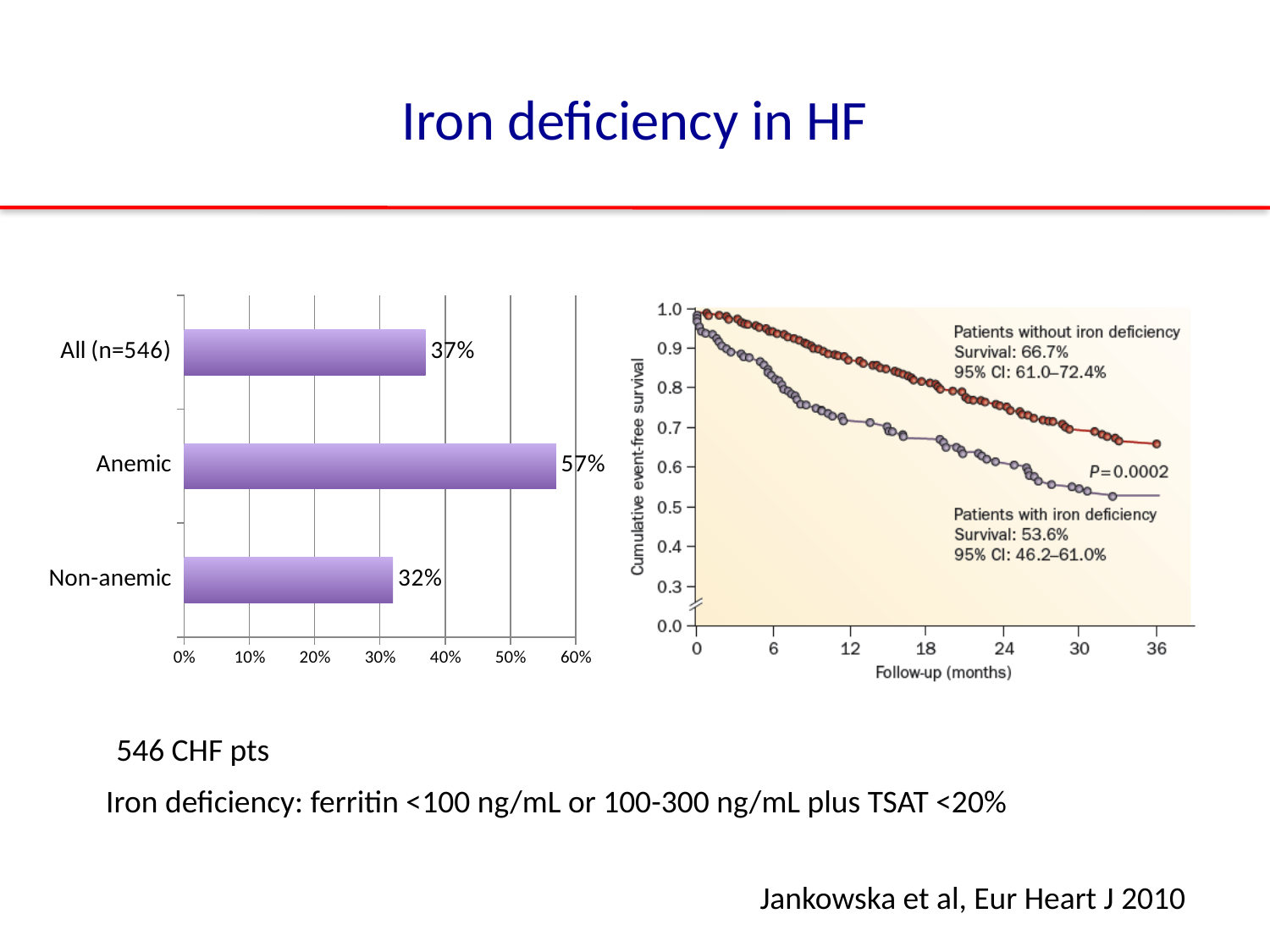
In the survival chart on the right, what is the label of the x axis? Follow-up (months) In the bar chart on the left, what is the value for Non-anemic? 32% What kind of chart is the chart on the left? Bar chart In the bar chart on the left, what is the difference between the Anemic and Non-anemic values? 25% In the survival chart on the right, what is the survival for patients with iron deficiency? 53.6% In the bar chart on the left, which category has the highest value? Anemic In the bar chart on the left, what is the value for All (n=546)? 37% In the bar chart on the left, which is larger, the value for All (n=546) or the value for Non-anemic? All (n=546) In the bar chart on the left, what is the value for Anemic? 57% In the bar chart on the left, which category has the lowest value? Non-anemic How many categories are shown in the bar chart on the left? 3 In the survival chart on the right, what is the survival for patients without iron deficiency? 66.7%